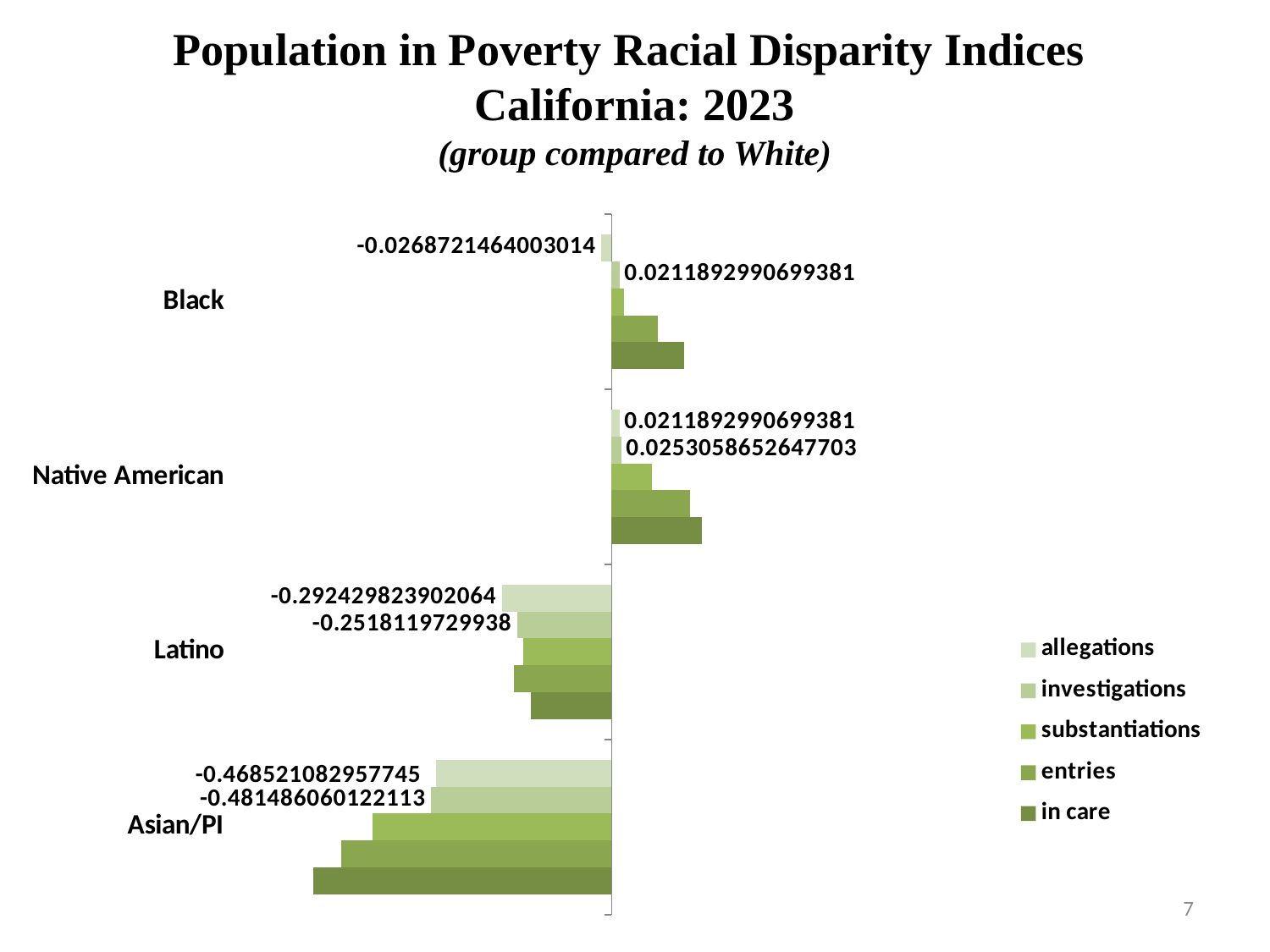
What is the allegations value for Latino? -0.292429823902064 What is the investigations value for Native American? 0.0253058652647703 What is the allegations value for Black? -0.0268721464003014 Which group has the highest allegations value? Native American Which series is listed last in the legend? in care For Asian/PI, which is larger: the allegations value or the investigations value? allegations For Latino, which is larger: the allegations value or the investigations value? investigations How many racial groups are shown on the chart? 4 What is the investigations value for Asian/PI? -0.481486060122113 Which group has the lowest investigations value? Asian/PI How many series does the legend list? 5 What kind of chart is shown on the slide? bar chart